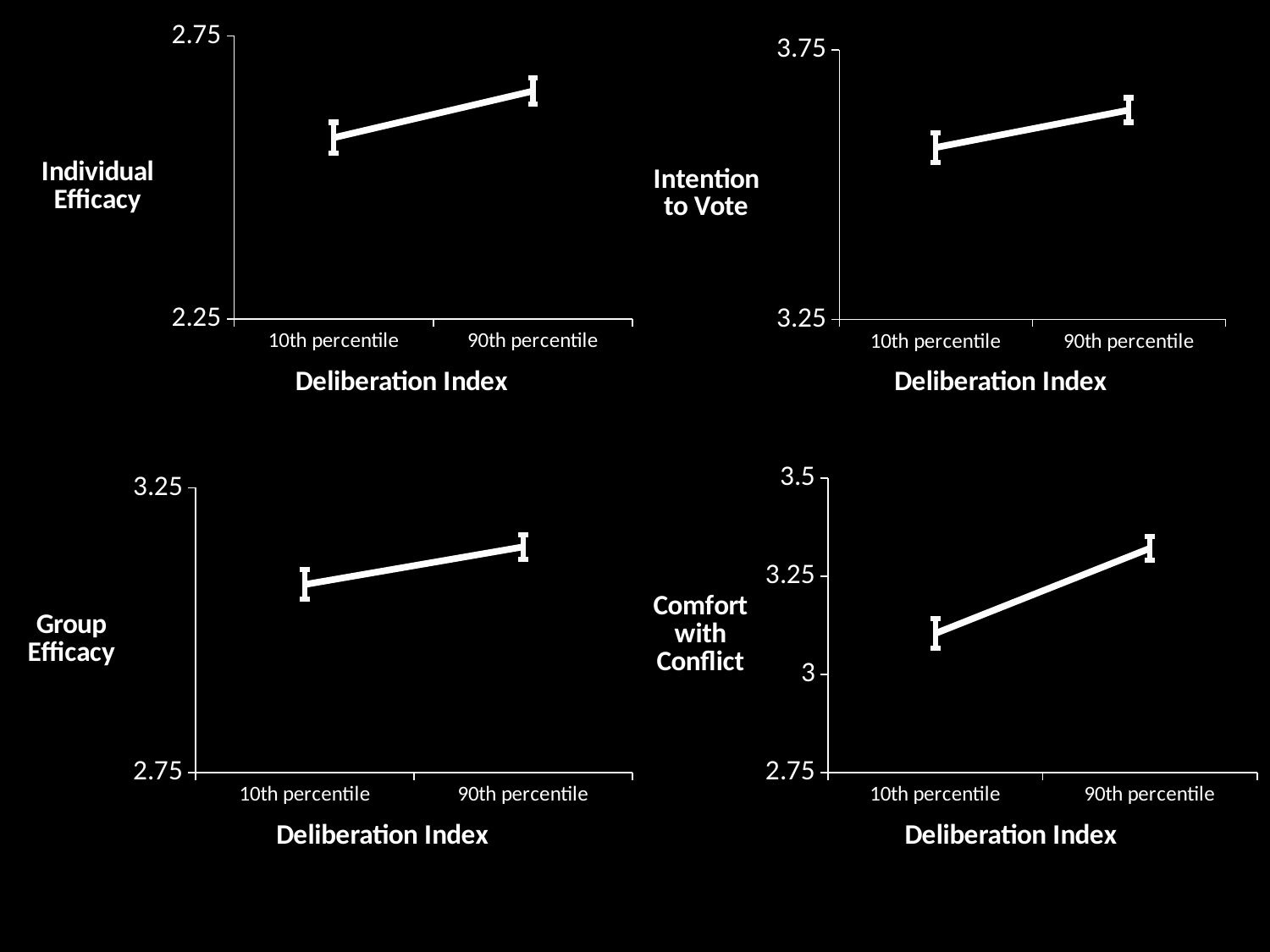
How many categories are shown on the x axis of the Intention to Vote chart (top right)? 2 In the Comfort with Conflict chart (bottom right), is the value for the 10th percentile greater or less than 3? greater How many charts are shown on the slide? 4 What is the x-axis title of the Group Efficacy chart (bottom left)? Deliberation Index In the Intention to Vote chart (top right), do values rise or fall along the x axis? rise In the Comfort with Conflict chart (bottom right), do values rise or fall from the 10th percentile to the 90th percentile? rise What kind of chart is the Individual Efficacy chart (top left)? line chart What is the highest y-axis tick value shown on the Comfort with Conflict chart (bottom right)? 3.5 In the Group Efficacy chart (bottom left), which category has the higher value, 10th percentile or 90th percentile? 90th percentile In the Individual Efficacy chart (top left), is the value for the 90th percentile greater or less than 2.75? less In the Individual Efficacy chart (top left), which category has the lowest value? 10th percentile In the Comfort with Conflict chart (bottom right), is the value for the 90th percentile greater or less than 3.25? greater